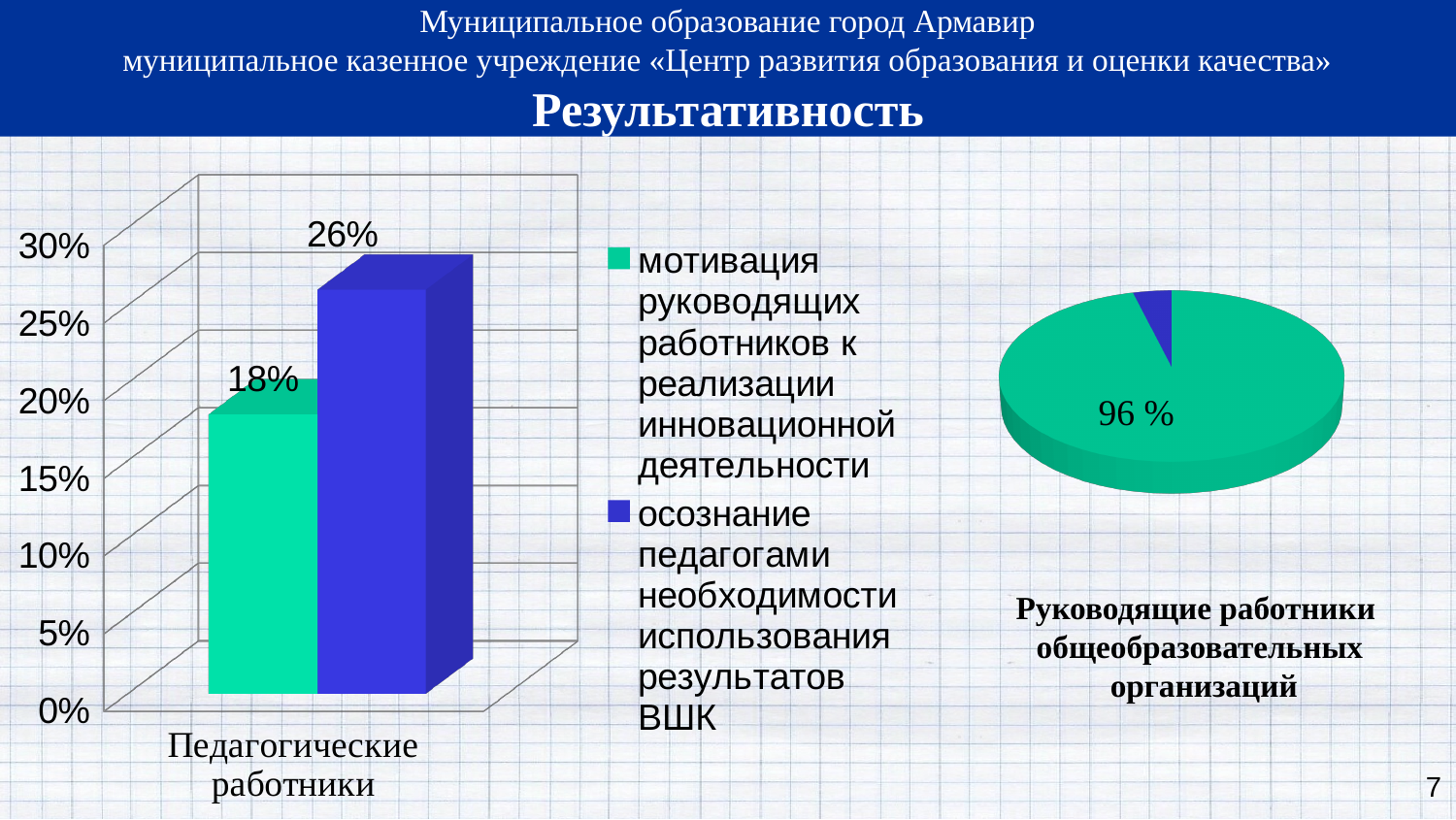
On the left bar chart, which series has the higher value? осознание педагогами необходимости использования результатов ВШК On the left bar chart, what is the difference between the two bars' values? 8% On the left bar chart, is the value for 'осознание педагогами необходимости использования результатов ВШК' greater or less than 25%? greater What kind of chart is shown on the left of the slide? bar chart On the left bar chart, what is the value for the series 'мотивация руководящих работников к реализации инновационной деятельности'? 18% What is the title of the pie chart on the right of the slide? Руководящие работники общеобразовательных организаций How many series does the legend of the left bar chart list? 2 On the left bar chart, what is the value for the series 'осознание педагогами необходимости использования результатов ВШК'? 26% On the right pie chart, what value is printed on the large green slice? 96 % On the left bar chart, which series has the lower value? мотивация руководящих работников к реализации инновационной деятельности On the left bar chart, is the value for 'мотивация руководящих работников к реализации инновационной деятельности' greater or less than 20%? less What is the category label on the x axis of the left bar chart? Педагогические работники